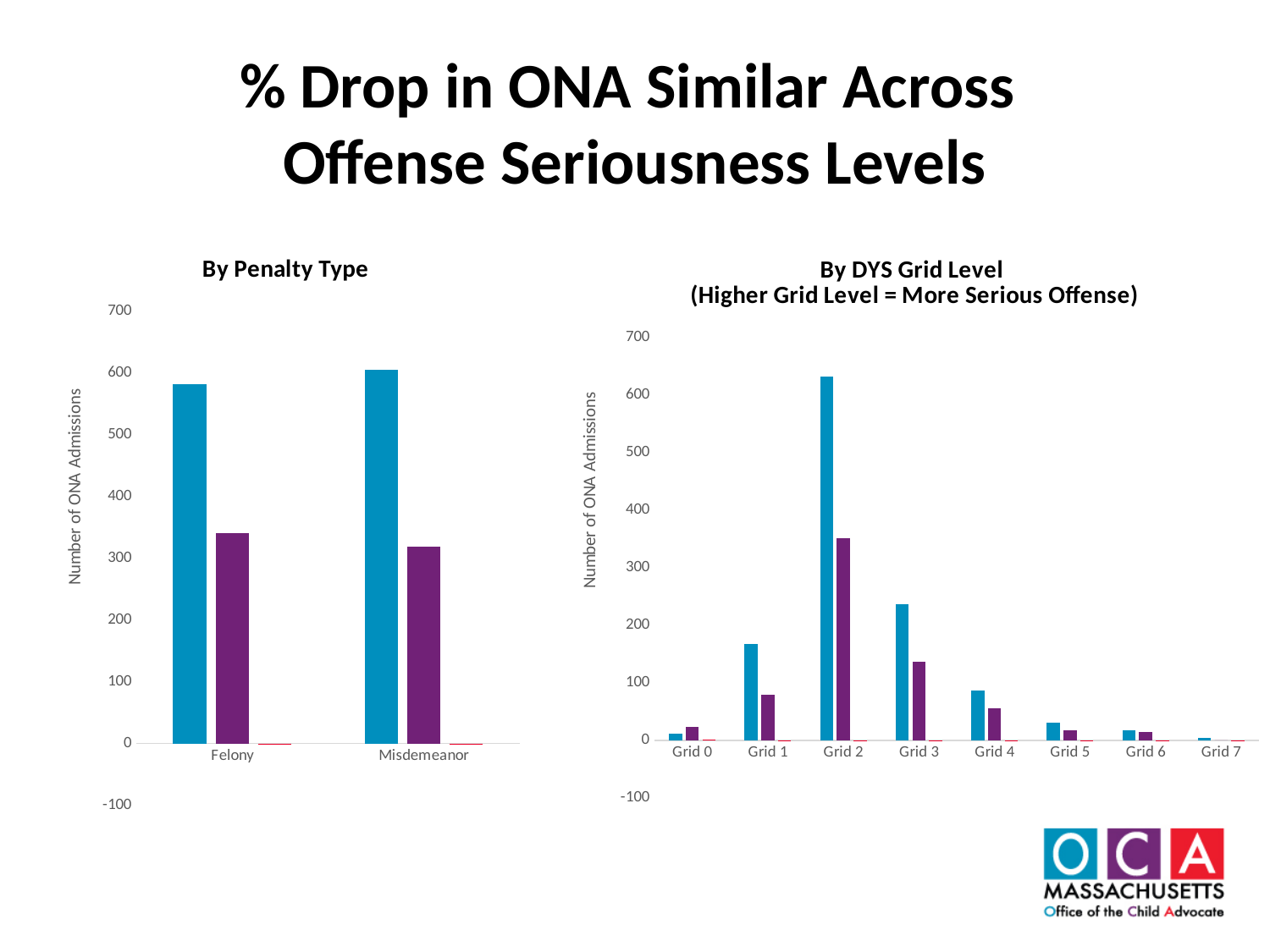
In the "By DYS Grid Level" chart, do the blue bars rise or fall from Grid 2 to Grid 7? fall How many categories are shown on the x axis of the "By DYS Grid Level" chart? 8 In the "By DYS Grid Level" chart, is the value of the blue bar for Grid 2 greater or less than 600? greater In the "By DYS Grid Level" chart, which grid level has the tallest blue bar? Grid 2 How many categories are shown on the x axis of the "By Penalty Type" chart? 2 In the "By Penalty Type" chart, is the value of the blue bar for Felony greater or less than 500? greater In the "By Penalty Type" chart, is the value of the purple bar for Misdemeanor greater or less than 400? less What is the y-axis label of the "By Penalty Type" chart? Number of ONA Admissions What kind of chart is the "By Penalty Type" chart? bar chart In the "By Penalty Type" chart, for Felony, which bar is taller, the blue bar or the purple bar? the blue bar In the "By DYS Grid Level" chart, which has the taller blue bar, Grid 1 or Grid 3? Grid 3